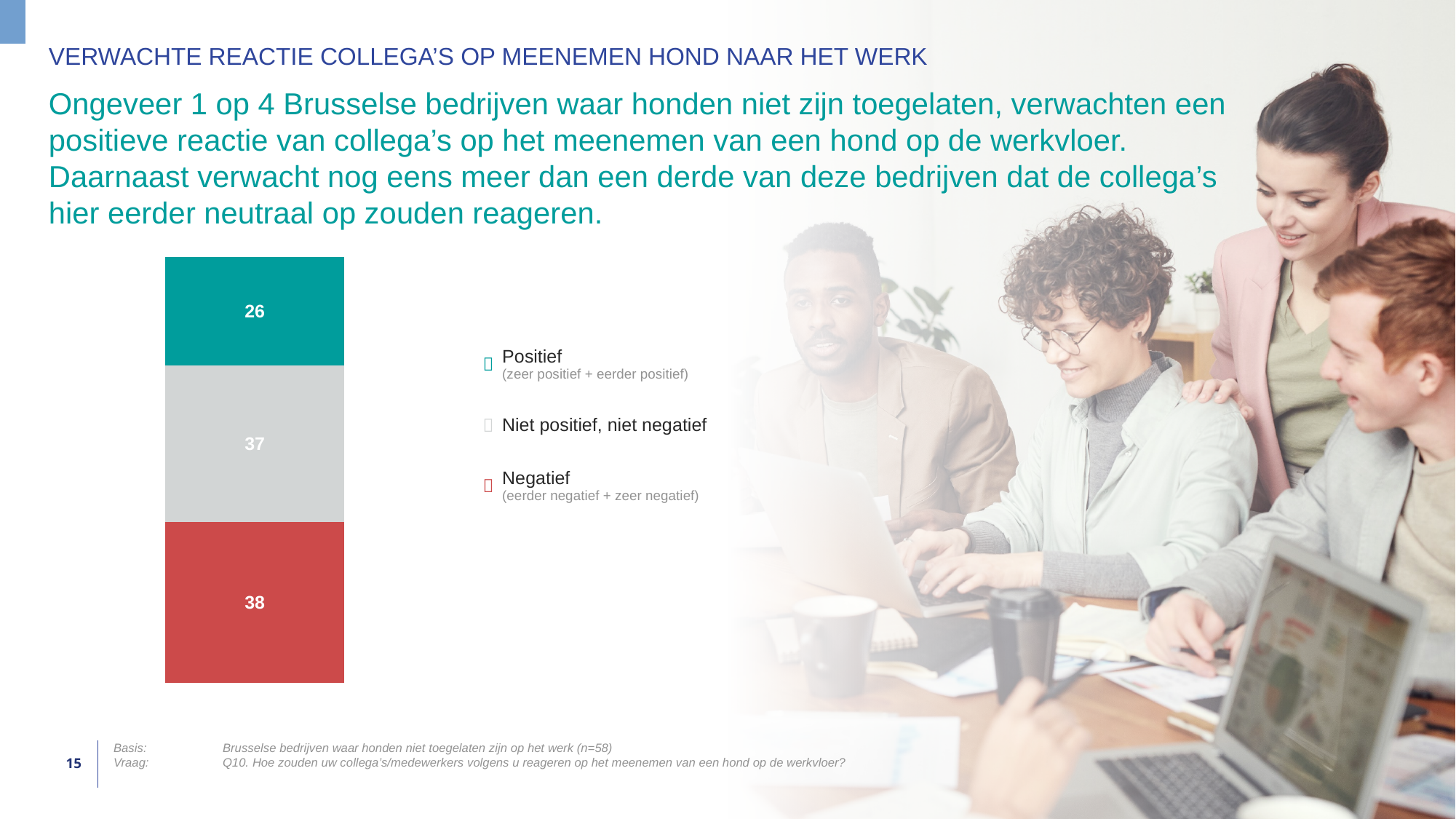
Which is larger, the value for Positief or the value for Niet positief, niet negatief? Niet positief, niet negatief Which segment of the stacked bar has the lowest value? Positief What value is shown for the Niet positief, niet negatief segment of the stacked bar? 37 What is the difference between the Niet positief, niet negatief value and the Positief value? 11 Which segment of the stacked bar has the highest value? Negatief What value is shown for the Positief segment of the stacked bar? 26 What colour is the Negatief segment of the bar? Red What kind of chart is shown on the slide? Stacked bar chart What is the difference between the Negatief value and the Positief value? 12 What value is shown for the Negatief segment of the stacked bar? 38 How many segments does the stacked bar contain? 3 How many entries does the legend list? 3